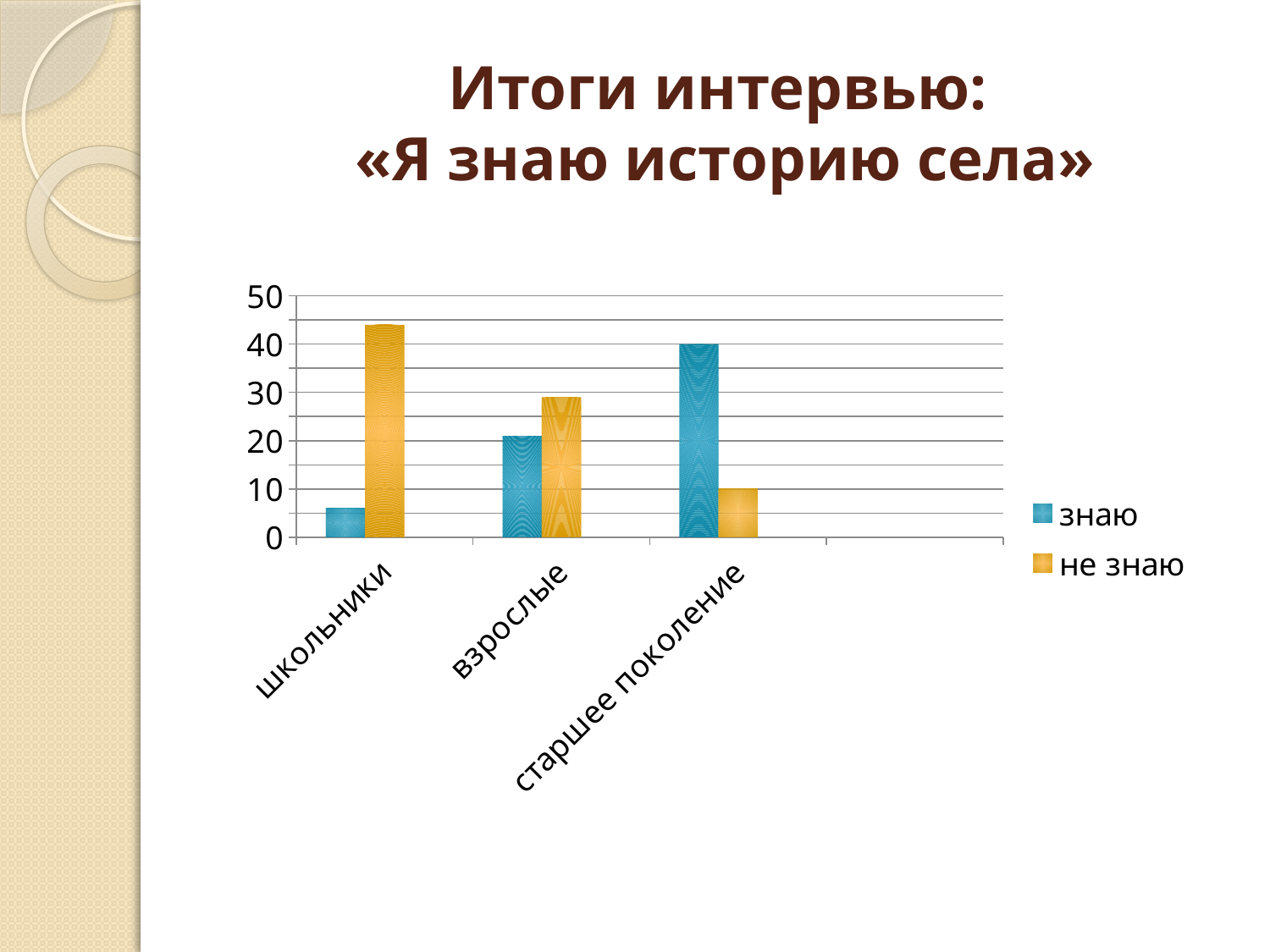
For "взрослые", which is larger: "знаю" or "не знаю"? не знаю What is the value of "не знаю" for "старшее поколение"? 10 Is the "не знаю" value for "школьники" greater or less than 40? greater Is the "знаю" value for "школьники" greater or less than 10? less Which series is shown in blue in the chart legend? знаю Which category has the highest "не знаю" value? школьники What is the value of "знаю" for "старшее поколение"? 40 What kind of chart is shown on the slide? bar chart How many series does the chart legend list? 2 How many categories are shown on the x axis of the chart? 3 Which category has the lowest "знаю" value? школьники Which category has the highest "знаю" value? старшее поколение